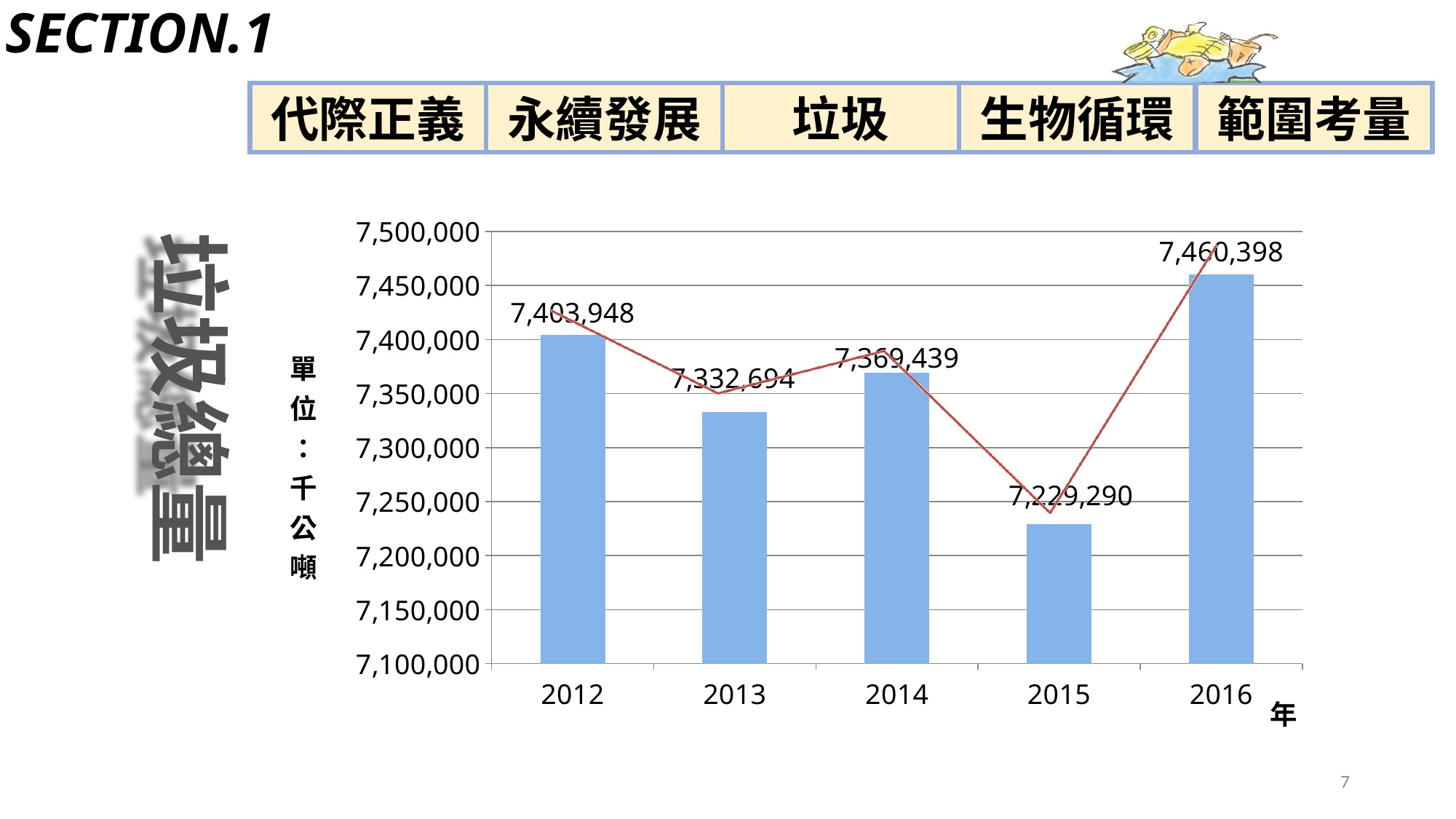
What is the value for 2013? 7,332,694 How many years are shown on the x axis? 5 What is the difference between the values for 2012 and 2013? 71,254 Is the value for 2015 greater or less than 7,250,000? less Which is larger, the value for 2014 or the value for 2013? 2014 Which year has the lowest value? 2015 Which year has the highest value? 2016 What is the difference between the values for 2016 and 2015? 231,108 What is the value for 2016? 7,460,398 What is the value for 2012? 7,403,948 What is the value for 2015? 7,229,290 What unit is given for the values on the chart? 千公噸